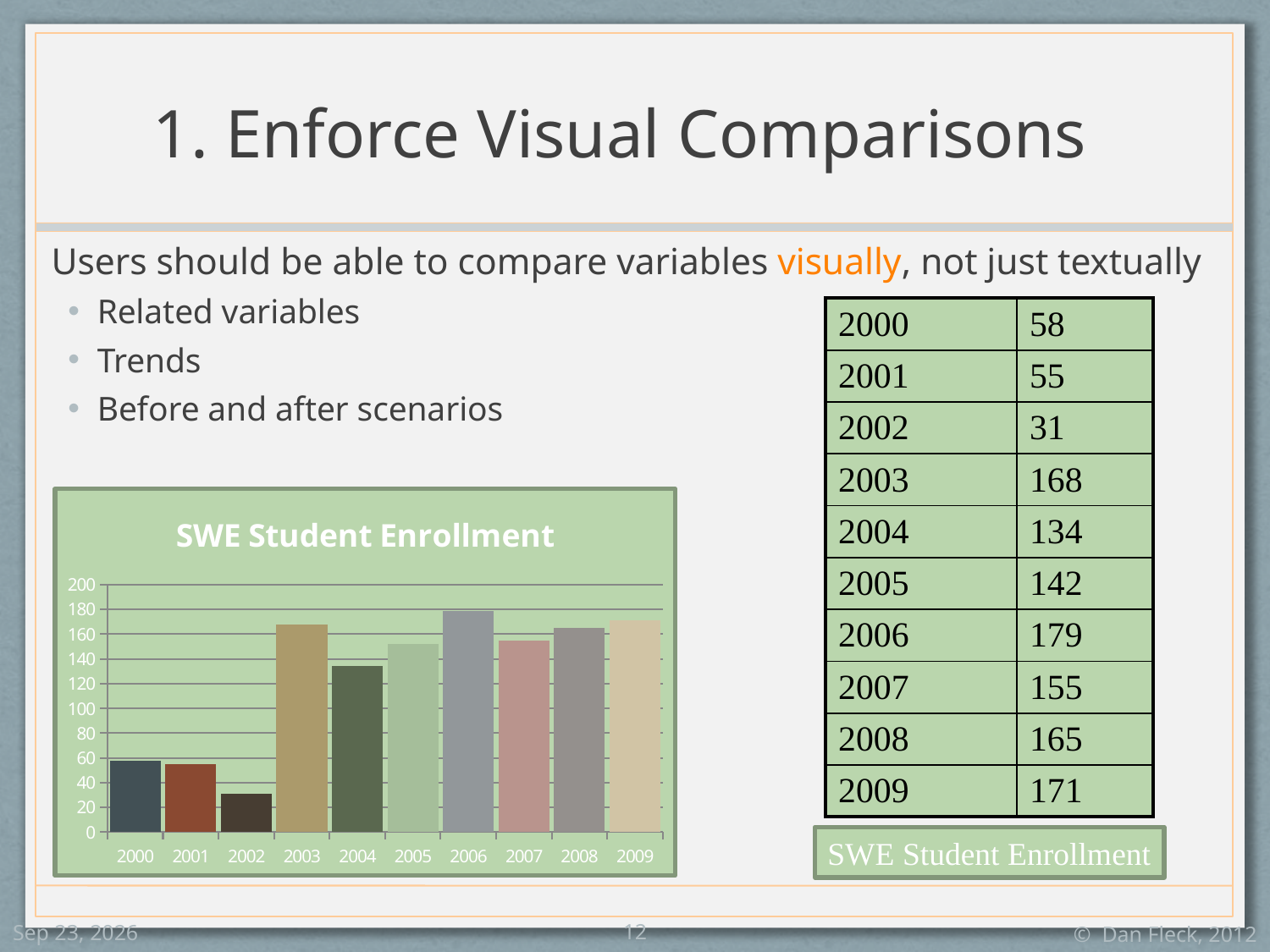
Which year has a larger enrollment, 2003 or 2004? 2003 What is the difference in enrollment between 2003 and 2002? 137 How many years are plotted on the x axis of the chart? 10 What type of chart is shown on the slide? bar chart What is the SWE student enrollment for 2003? 168 Which year has the lowest SWE student enrollment? 2002 Which year has the highest SWE student enrollment? 2006 What is the title of the chart? SWE Student Enrollment Does enrollment rise or fall from 2000 to 2002? fall What is the SWE student enrollment for 2009? 171 Is the enrollment value for 2001 greater or less than 60? less Is the enrollment value for 2004 greater or less than 120? greater